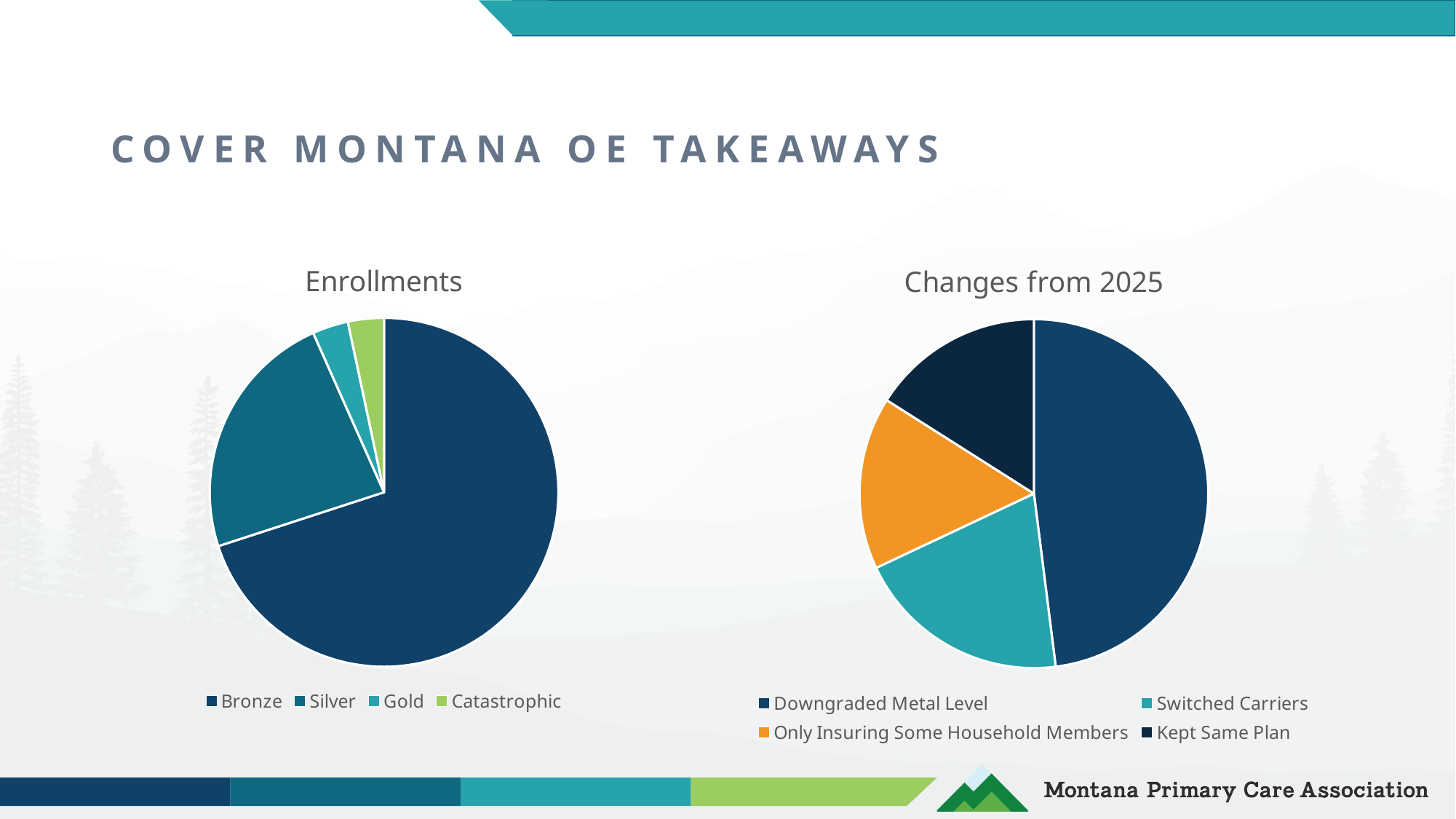
How many categories does the legend of the Changes from 2025 chart list? 4 In the Changes from 2025 chart, which category is shown in orange? Only Insuring Some Household Members In the Enrollments chart, which slice is larger, Silver or Gold? Silver How many slices does the Enrollments pie chart have? 4 What kind of chart is the Enrollments chart? pie chart In the Changes from 2025 chart, which slice is larger, Downgraded Metal Level or Switched Carriers? Downgraded Metal Level In the Changes from 2025 chart, which category has the largest slice? Downgraded Metal Level In the Enrollments chart, which category has the largest slice? Bronze In the Changes from 2025 chart, which slice is larger, Switched Carriers or Only Insuring Some Household Members? Switched Carriers What kind of chart is the Changes from 2025 chart? pie chart What is the title of the pie chart on the right side of the slide? Changes from 2025